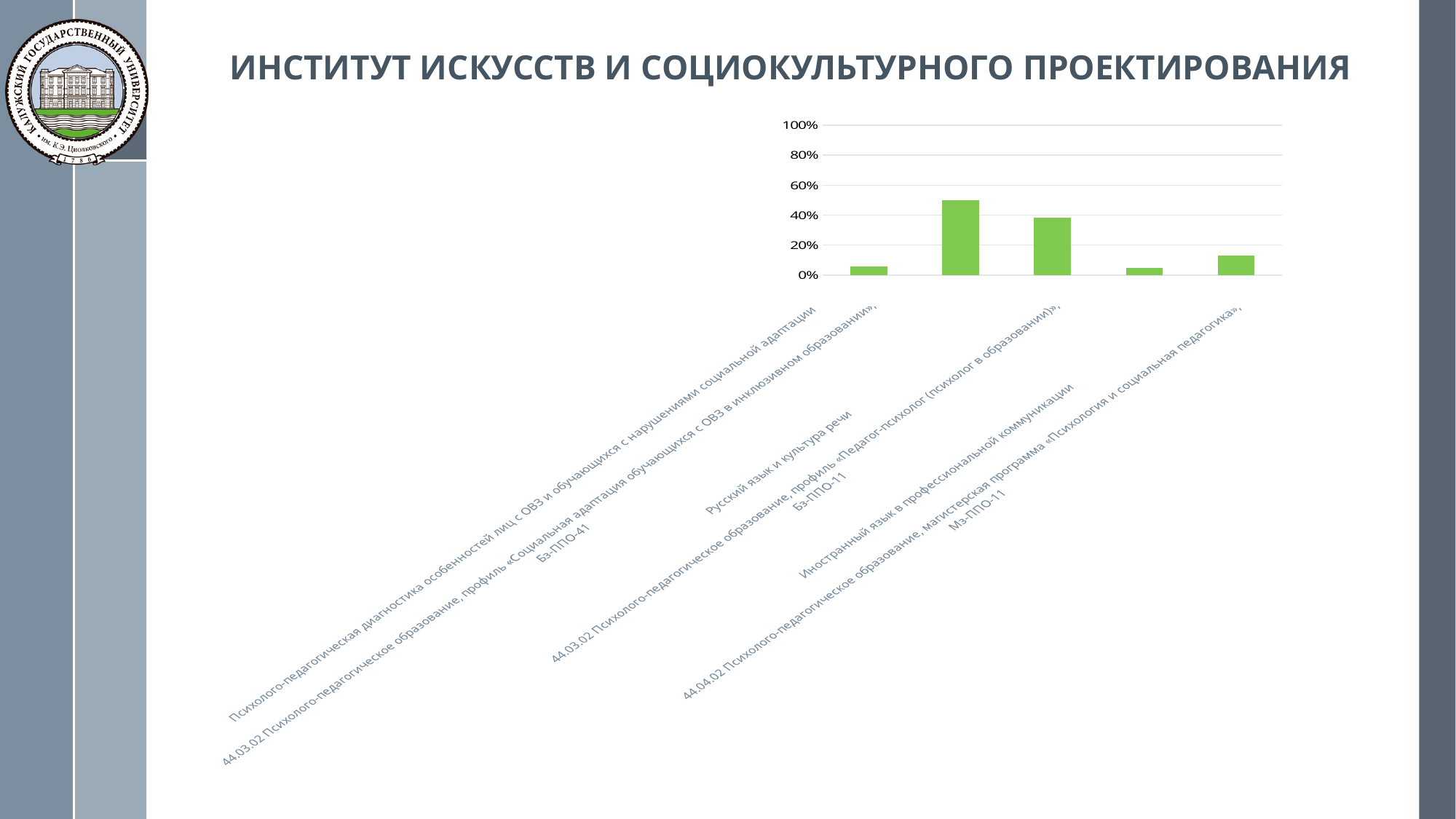
What colour are the bars in the chart? green Is the value of the fifth bar from the left greater or less than 20%? less What kind of chart is shown on the slide? bar chart Which is larger, the second bar or the third bar from the left? the second bar Is the value of the second bar from the left greater or less than 40%? greater How many bars are plotted in the chart? 5 Which bar is the tallest in the chart, counting from the left? the second bar Is the value of the fourth bar from the left greater or less than 20%? less What is the highest value shown on the vertical axis of the chart? 100% Which is larger, the fifth bar or the fourth bar from the left? the fifth bar